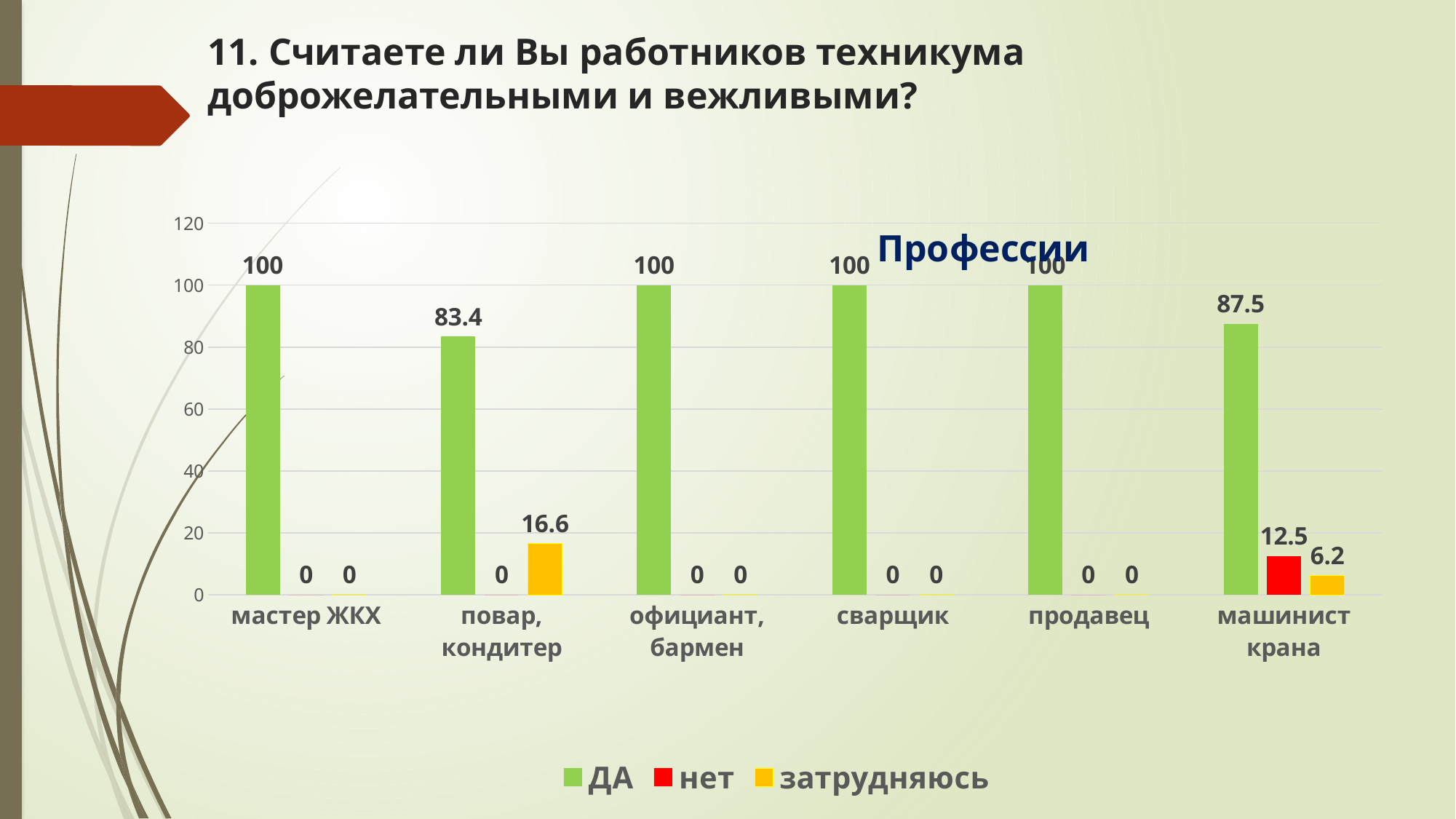
Which is larger: the ДА value for повар, кондитер or the ДА value for машинист крана? машинист крана How many series does the legend list? 3 Which category has the highest value in the затрудняюсь series? повар, кондитер What colour represents the нет series in the legend? red What is the value of the ДА series for повар, кондитер? 83.4 What is the value of the затрудняюсь series for повар, кондитер? 16.6 What is the value of the нет series for машинист крана? 12.5 What kind of chart is shown on the slide? bar chart Which category has the lowest value in the ДА series? повар, кондитер What is the value of the затрудняюсь series for машинист крана? 6.2 What is the difference between the ДА values for мастер ЖКХ and машинист крана? 12.5 How many categories are shown on the x axis? 6